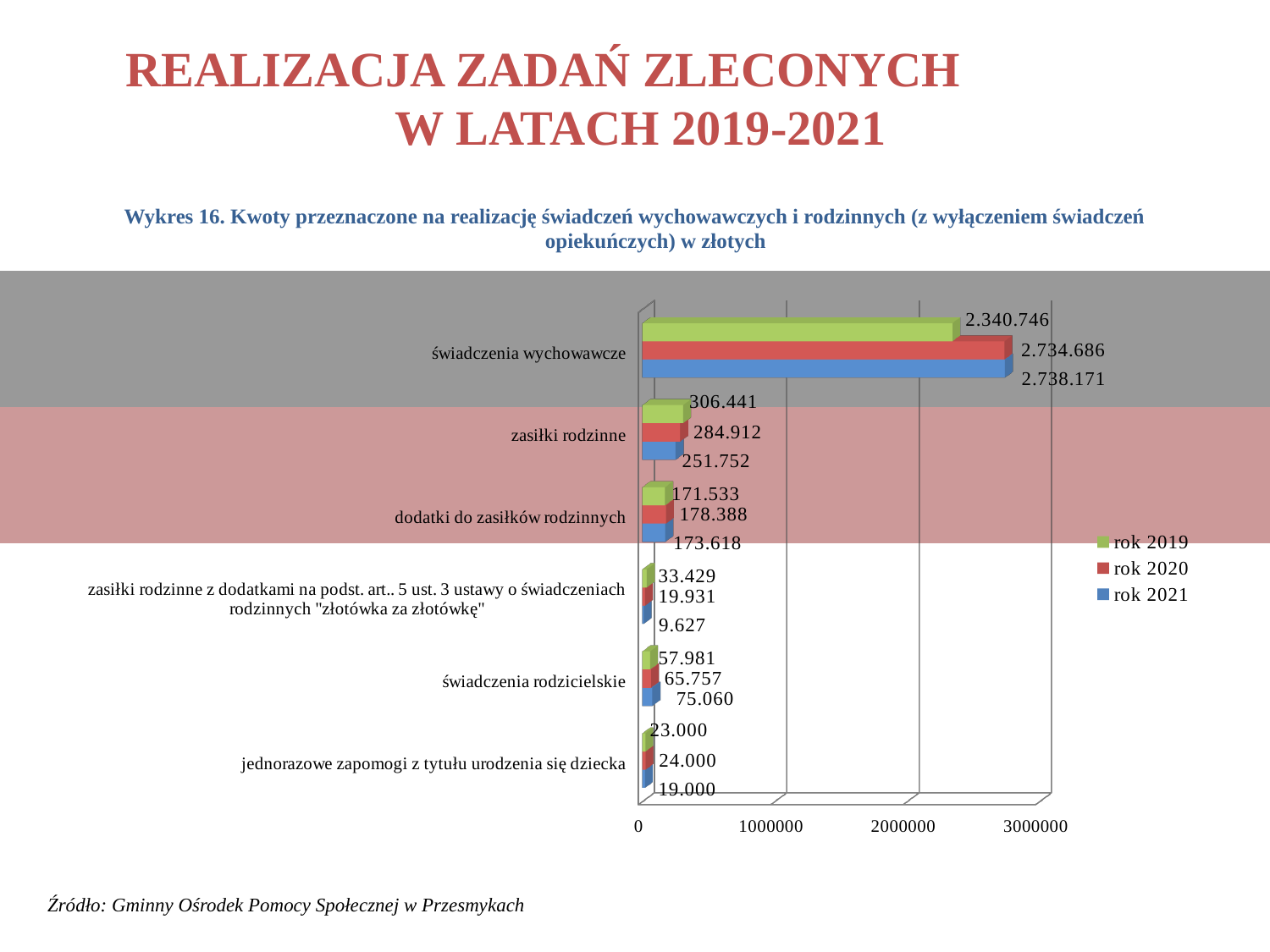
What is the value for świadczenia rodzicielskie in rok 2020? 65.757 Which category has the lowest value in rok 2021? zasiłki rodzinne z dodatkami na podst. art.. 5 ust. 3 ustawy o świadczeniach rodzinnych "złotówka za złotówkę" How many categories are shown on the chart? 6 What is the value for świadczenia wychowawcze in rok 2021? 2.738.171 Which is larger for rok 2020: zasiłki rodzinne or dodatki do zasiłków rodzinnych? zasiłki rodzinne Do the values for świadczenia rodzicielskie rise or fall from rok 2019 to rok 2021? rise What is the value for zasiłki rodzinne in rok 2019? 306.441 What is the difference between the rok 2019 and rok 2021 values for zasiłki rodzinne? 54.689 Which category has the highest value in rok 2021? świadczenia wychowawcze How many series does the legend list? 3 What kind of chart is shown on the slide? bar chart What is the value for jednorazowe zapomogi z tytułu urodzenia się dziecka in rok 2021? 19.000